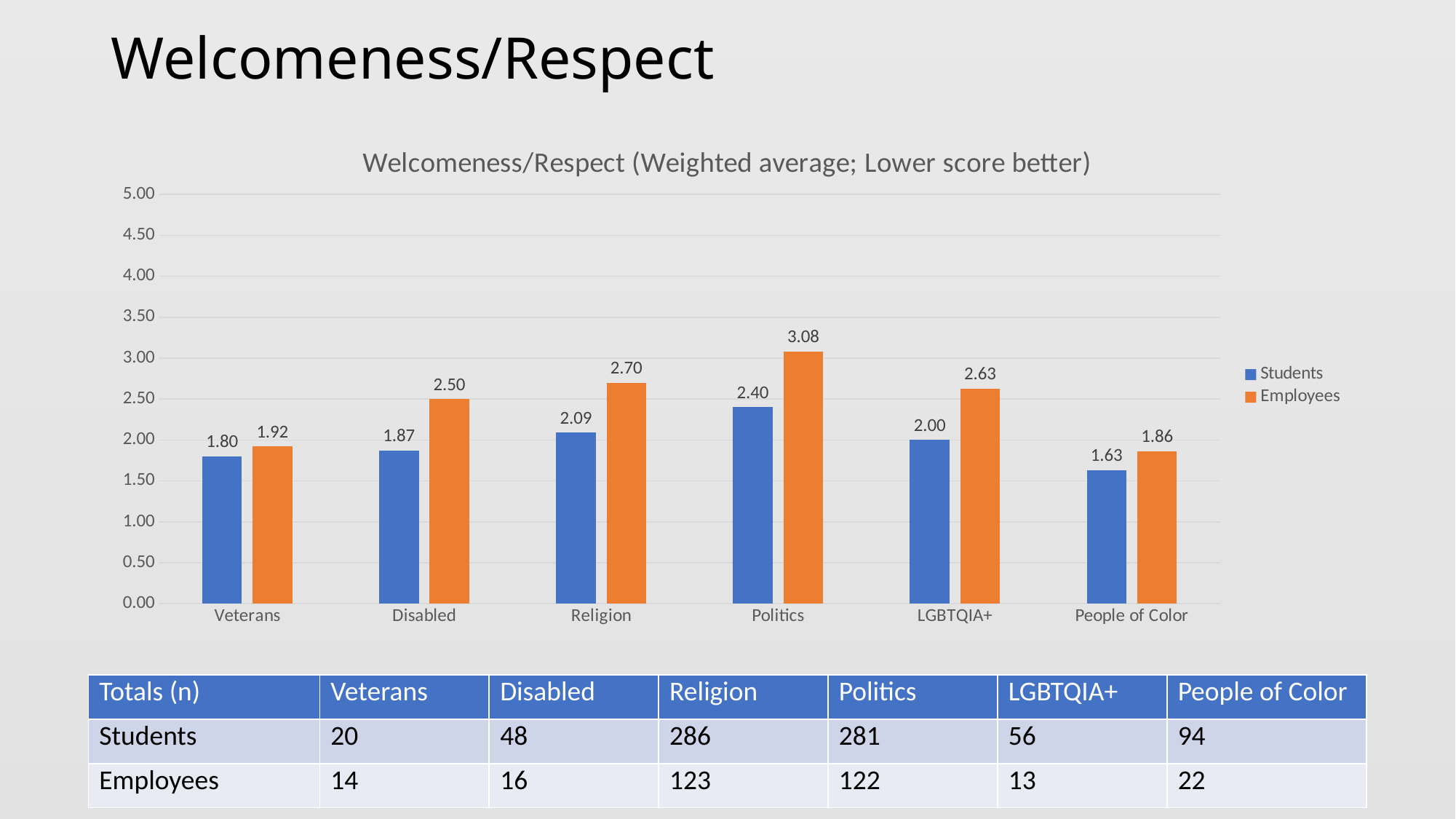
What is the difference between the Employees and Students values for Politics? 0.68 Which category has the lowest Students value? People of Color Which is larger for Religion, the Students value or the Employees value? Employees What is the Employees value for Disabled? 2.50 Which category has the highest Employees value? Politics How many categories are shown on the x axis? 6 What is the Students value for People of Color? 1.63 What is the Students value for Politics? 2.40 What is the title of the chart? Welcomeness/Respect (Weighted average; Lower score better) Is the Employees value for LGBTQIA+ greater or less than 3.00? less What kind of chart is shown? bar chart How many series does the legend list? 2